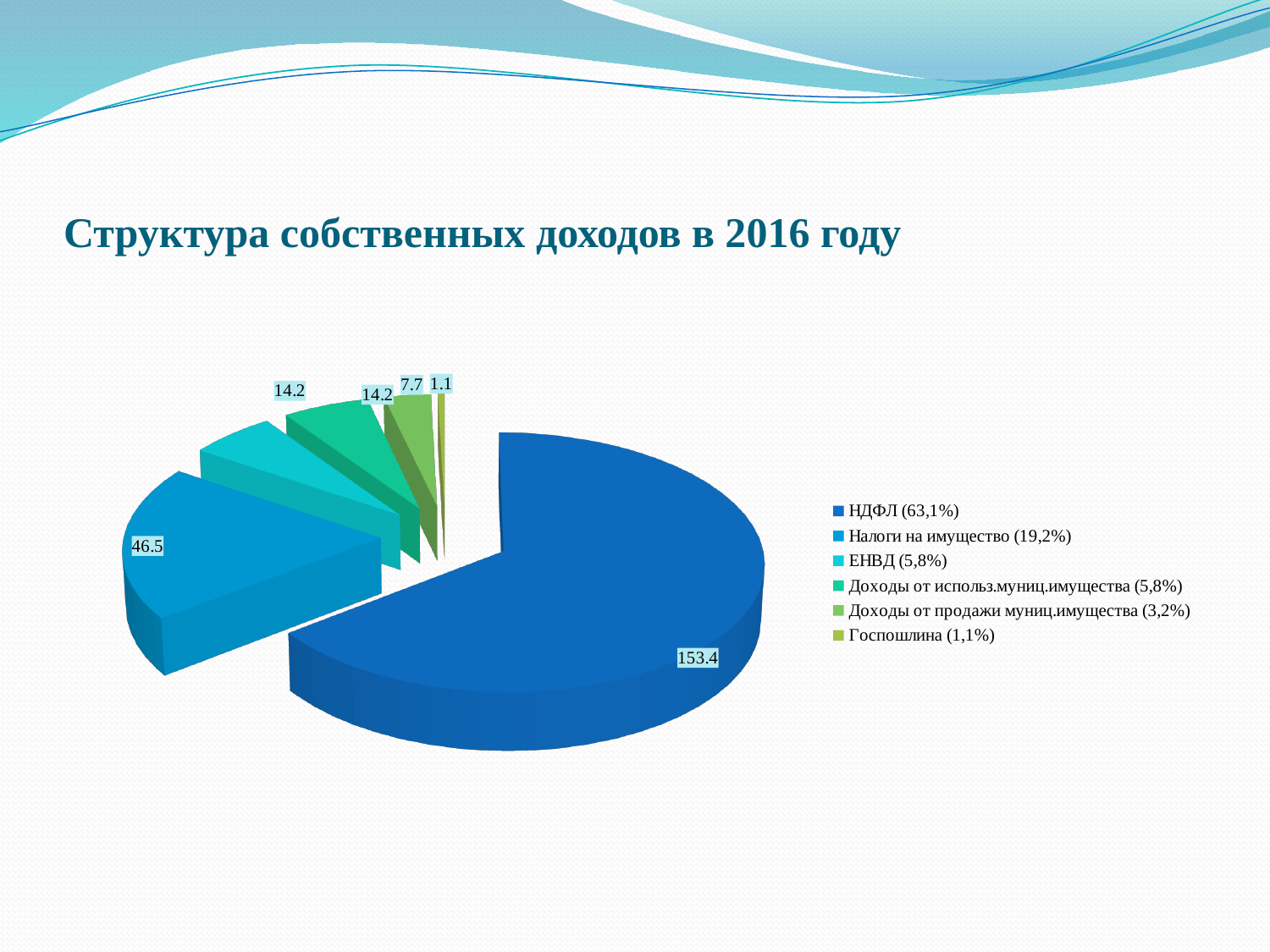
What share of the pie does Налоги на имущество represent, according to the legend? 19,2% What is the value for Доходы от продажи муниц.имущества? 7.7 How many categories does the pie chart have? 6 What is the title of the slide containing the chart? Структура собственных доходов в 2016 году What is the value for Налоги на имущество? 46.5 Which is larger, the value for Налоги на имущество or the value for Доходы от продажи муниц.имущества? Налоги на имущество What is the value for Госпошлина? 1.1 Which category has the smallest slice of the pie? Госпошлина What is the value for НДФЛ? 153.4 Which category has the largest slice of the pie? НДФЛ What kind of chart is shown on the slide? Pie chart What is the difference between the values for НДФЛ and Налоги на имущество? 106.9